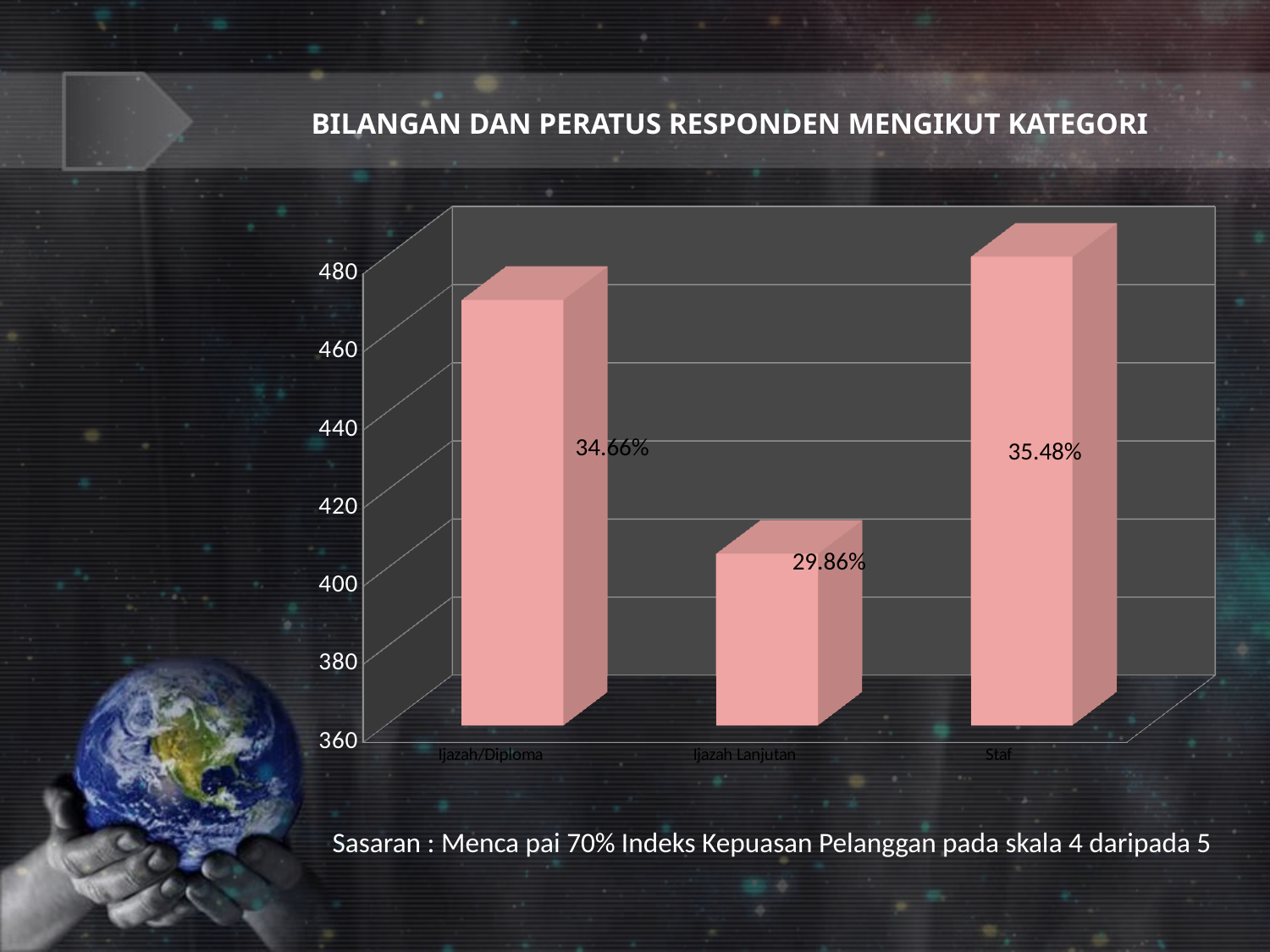
What percentage label is shown on the Staf bar? 35.48% What is the difference between the percentage labels for Ijazah/Diploma and Ijazah Lanjutan? 4.80% What percentage label is shown on the Ijazah/Diploma bar? 34.66% What is the difference between the percentage labels for Staf and Ijazah Lanjutan? 5.62% Which category has the highest bar? Staf Is the value for Ijazah Lanjutan greater or less than 420? less What percentage label is shown on the Ijazah Lanjutan bar? 29.86% Which category has the lowest bar? Ijazah Lanjutan Which is larger, the bar for Ijazah/Diploma or the bar for Ijazah Lanjutan? Ijazah/Diploma How many categories are shown on the x axis? 3 Is the value for Ijazah/Diploma greater or less than 460? greater What kind of chart is shown on the slide? Bar chart